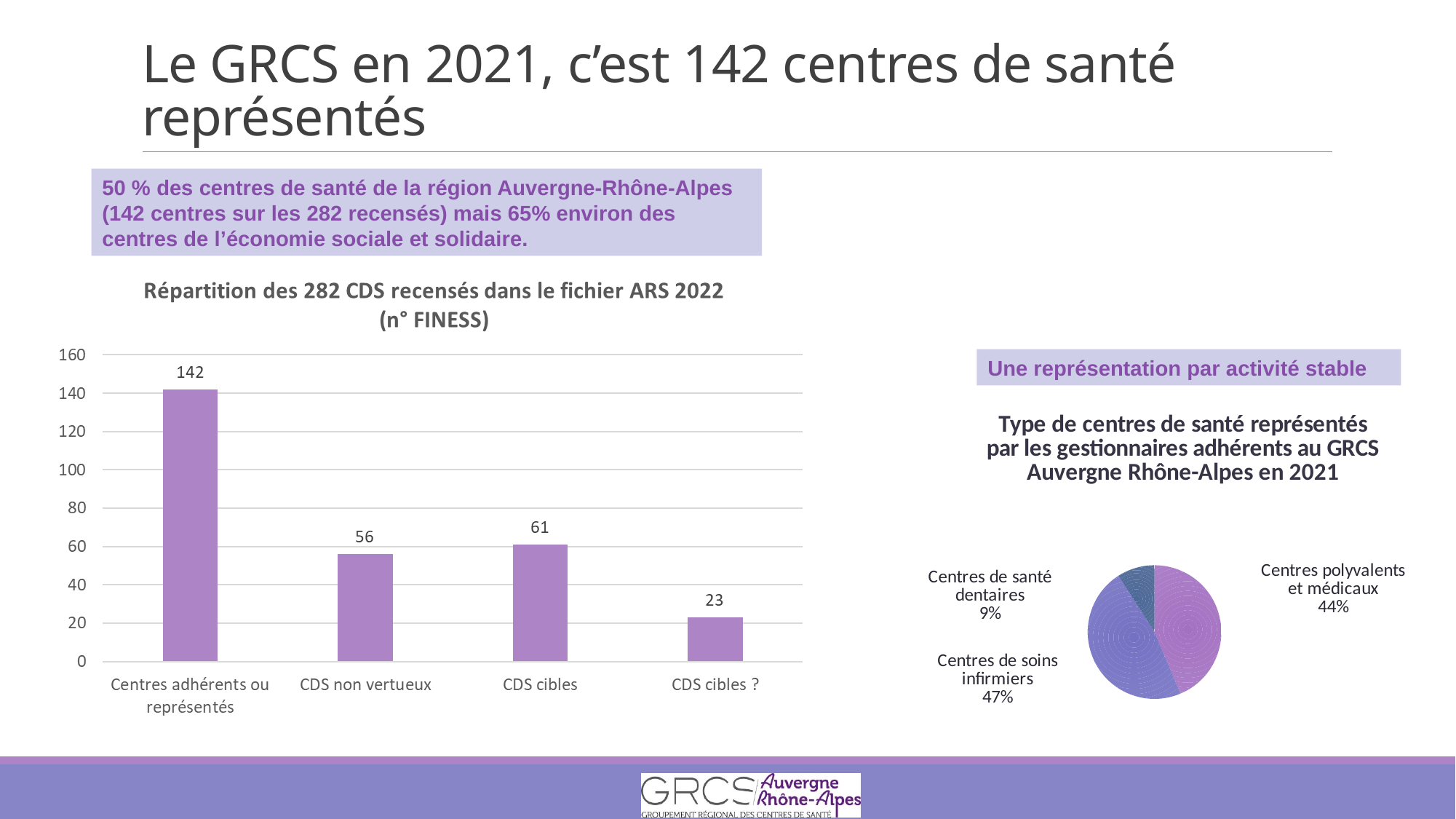
In the bar chart 'Répartition des 282 CDS recensés dans le fichier ARS 2022 (n° FINESS)', which category has the lowest value? CDS cibles ? In the bar chart 'Répartition des 282 CDS recensés dans le fichier ARS 2022 (n° FINESS)', what is the difference between 'CDS cibles' and 'CDS non vertueux'? 5 In the bar chart 'Répartition des 282 CDS recensés dans le fichier ARS 2022 (n° FINESS)', what is the value for 'CDS cibles ?'? 23 In the bar chart 'Répartition des 282 CDS recensés dans le fichier ARS 2022 (n° FINESS)', which category has the highest value? Centres adhérents ou représentés In the pie chart 'Type de centres de santé représentés par les gestionnaires adhérents au GRCS Auvergne Rhône-Alpes en 2021', what share is 'Centres de soins infirmiers'? 47% In the bar chart 'Répartition des 282 CDS recensés dans le fichier ARS 2022 (n° FINESS)', which is larger: 'CDS cibles' or 'CDS non vertueux'? CDS cibles In the pie chart 'Type de centres de santé représentés par les gestionnaires adhérents au GRCS Auvergne Rhône-Alpes en 2021', how many slices are there? 3 In the bar chart 'Répartition des 282 CDS recensés dans le fichier ARS 2022 (n° FINESS)', how many categories are shown? 4 In the pie chart 'Type de centres de santé représentés par les gestionnaires adhérents au GRCS Auvergne Rhône-Alpes en 2021', which slice is the smallest? Centres de santé dentaires What kind of chart is 'Répartition des 282 CDS recensés dans le fichier ARS 2022 (n° FINESS)'? Bar chart In the bar chart 'Répartition des 282 CDS recensés dans le fichier ARS 2022 (n° FINESS)', what is the value for 'CDS non vertueux'? 56 In the bar chart 'Répartition des 282 CDS recensés dans le fichier ARS 2022 (n° FINESS)', what is the value for 'Centres adhérents ou représentés'? 142